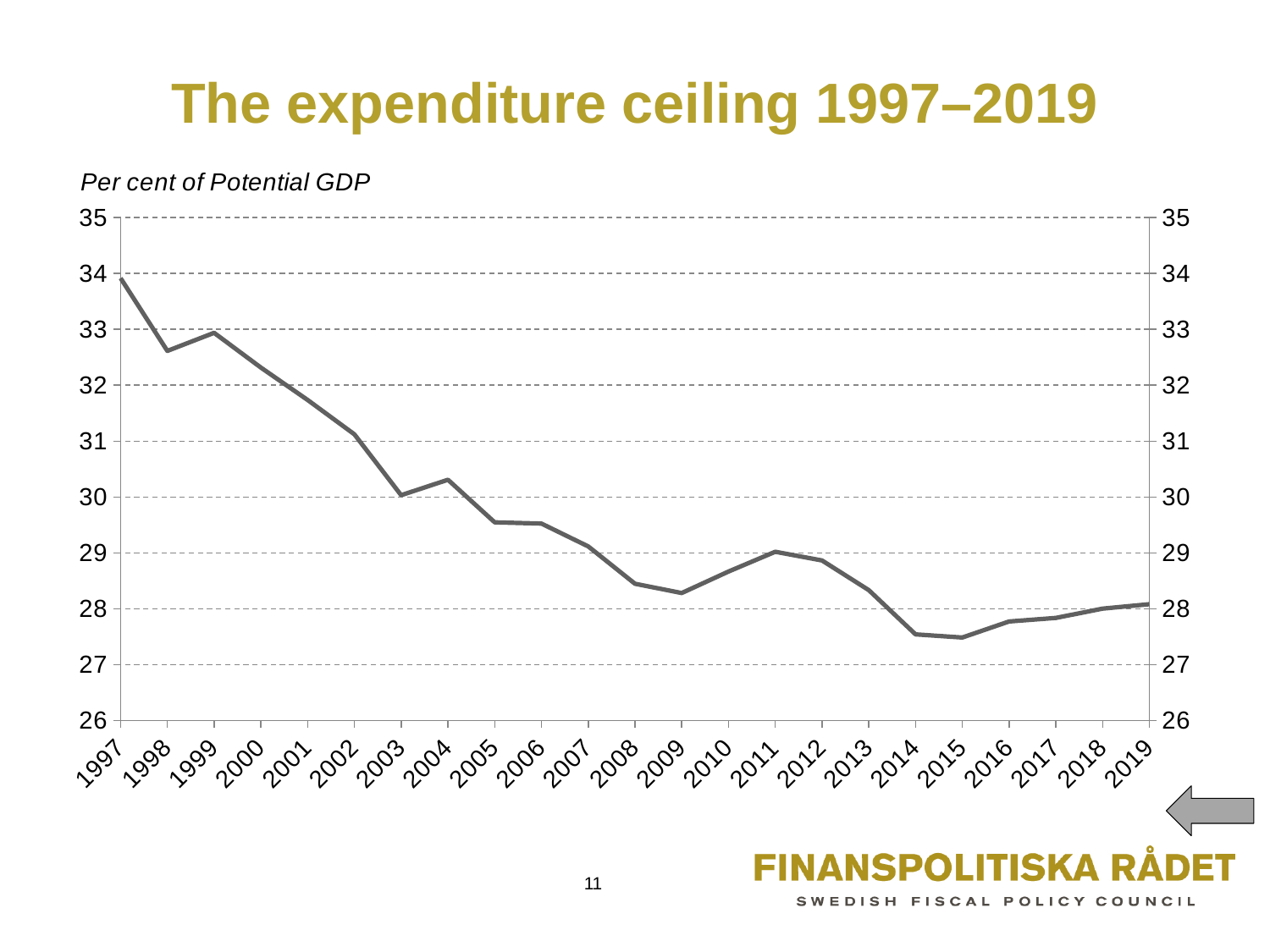
Overall, do the values rise or fall from 1997 to 2019? fall Is the value for 2002 greater or less than 31? greater Which is larger, the value for 2011 or the value for 2014? 2011 Is the value for 2008 greater or less than 29? less What unit is the expenditure ceiling measured in, according to the label above the chart? Per cent of Potential GDP How many years are plotted along the x axis? 23 Is the value for 2014 greater or less than 28? less Which year has the highest expenditure ceiling as a per cent of potential GDP? 1997 What kind of chart is shown on the slide? line chart Which is larger, the value for 1997 or the value for 2019? 1997